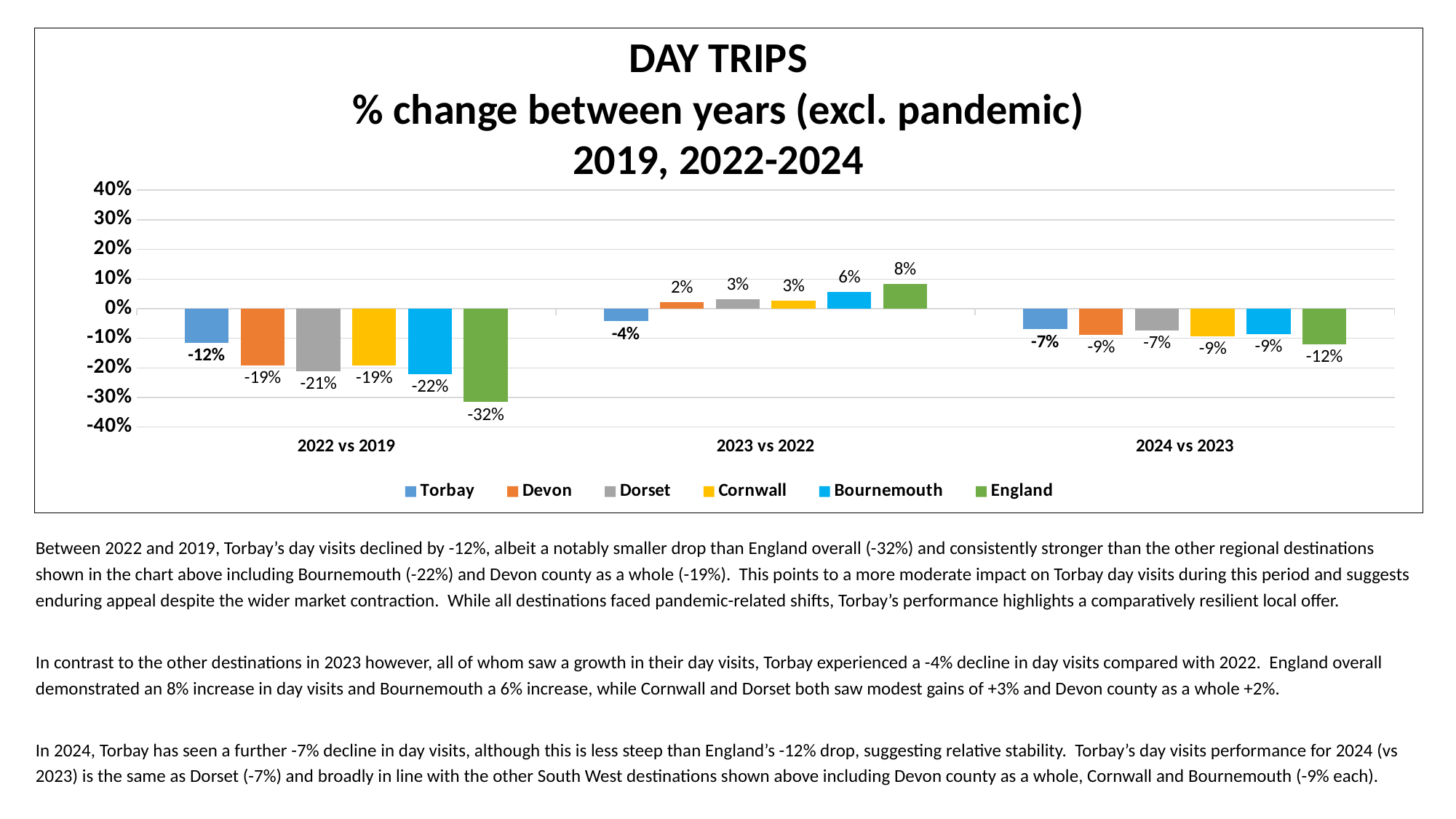
What kind of chart is shown on the slide? Bar chart How many category groups are shown on the x axis? 3 What is the value for Cornwall in the 2024 vs 2023 group? -9% In the 2023 vs 2022 group, which is larger: the value for Bournemouth or the value for Devon? Bournemouth What is the difference between the England and Torbay values in the 2022 vs 2019 group? 20 percentage points Which series has the lowest value in the 2022 vs 2019 group? England What is the value for Bournemouth in the 2022 vs 2019 group? -22% What is the value for Torbay in the 2022 vs 2019 group? -12% What is the value for England in the 2023 vs 2022 group? 8% Which series has the highest value in the 2023 vs 2022 group? England How many series does the legend list? 6 Which colour represents England in the legend? Green